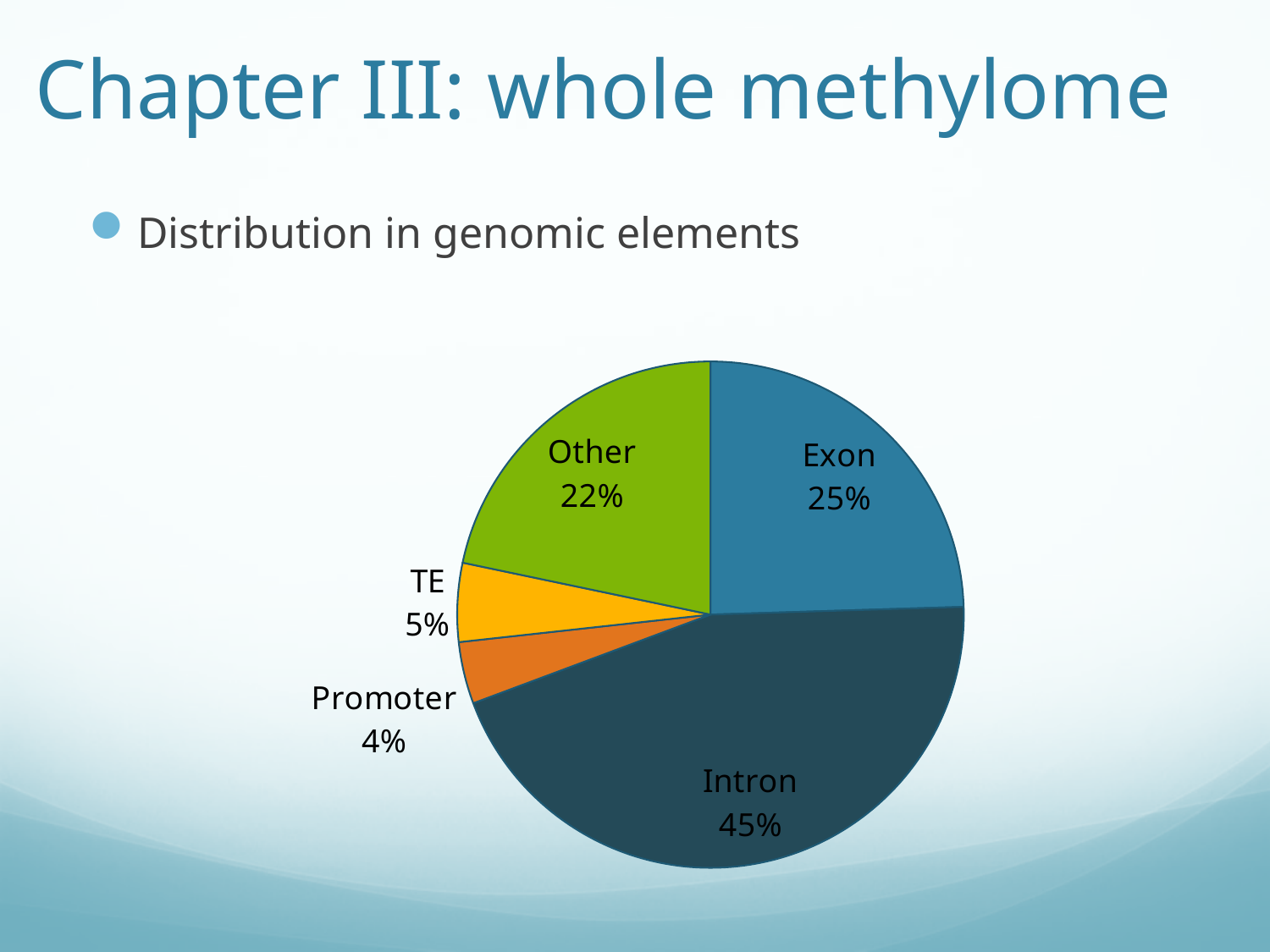
Which is larger, the share for Exon or the share for Other? Exon What share of the pie does Intron account for? 45% Which genomic element has the smallest slice of the pie? Promoter What colour is the Intron slice? dark teal What is the value shown for Exon? 25% What is the value shown for Promoter? 4% Which genomic element has the largest slice of the pie? Intron What is the value shown for Other? 22% What is the value shown for TE? 5% How many slices does the pie chart have? 5 What is the difference in percentage points between Intron and Exon? 20 What kind of chart is shown on the slide? pie chart